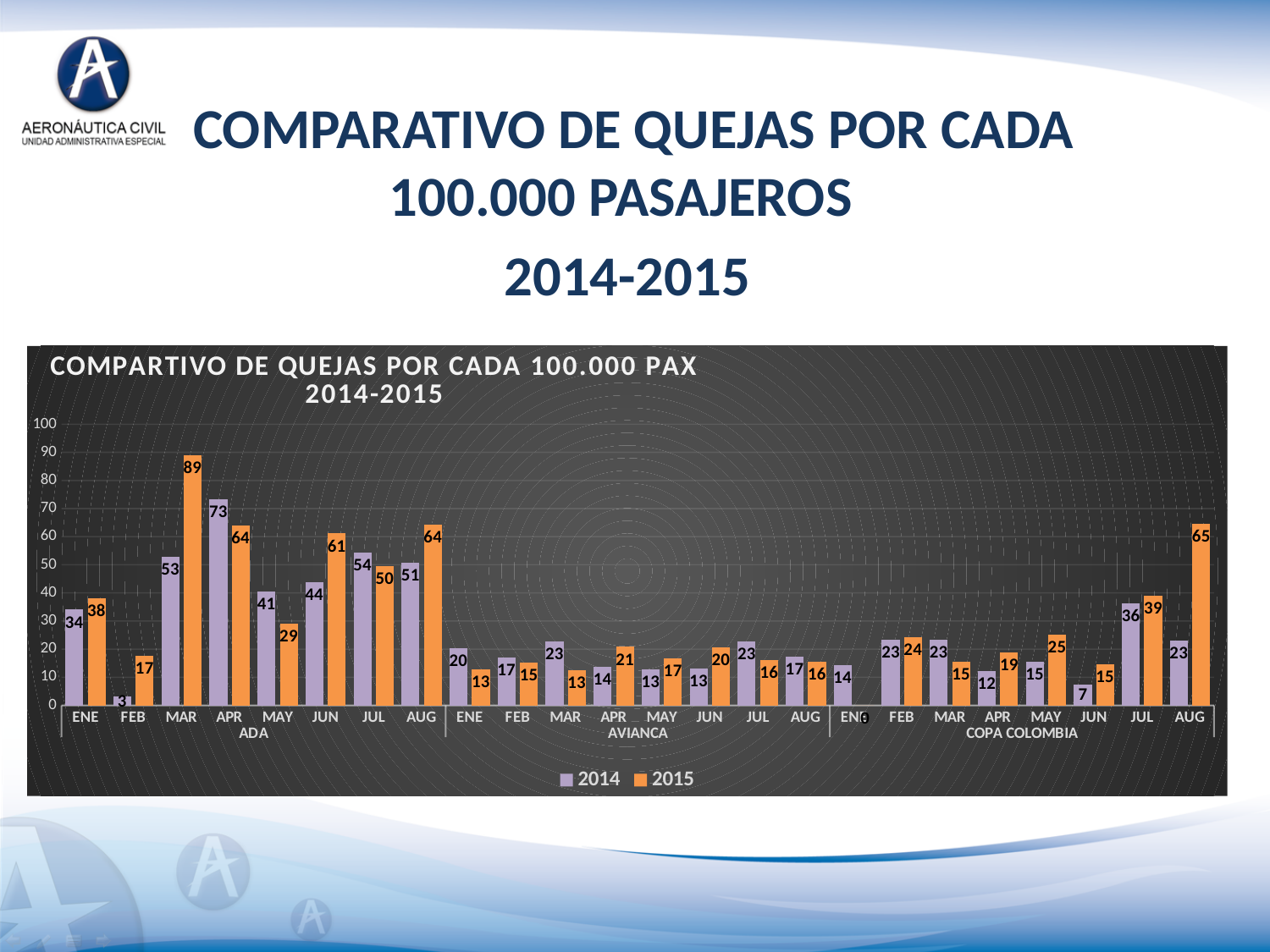
Which is larger for COPA COLOMBIA in AUG, the 2014 value or the 2015 value? 2015 What kind of chart is shown? Bar chart How many series does the legend list? 2 Which month has the lowest 2014 value for ADA? FEB What is the 2015 value for COPA COLOMBIA in AUG? 65 Which airline and month has the highest 2015 value? ADA, MAR Is the 2014 value for ADA in JUL greater or less than 50? greater What is the 2014 value for ADA in APR? 73 What is the 2014 value for AVIANCA in JUL? 23 What is the 2015 value for ADA in MAR? 89 What is the difference between the 2015 and 2014 values for ADA in MAR? 36 Which colour represents the 2015 series? Orange